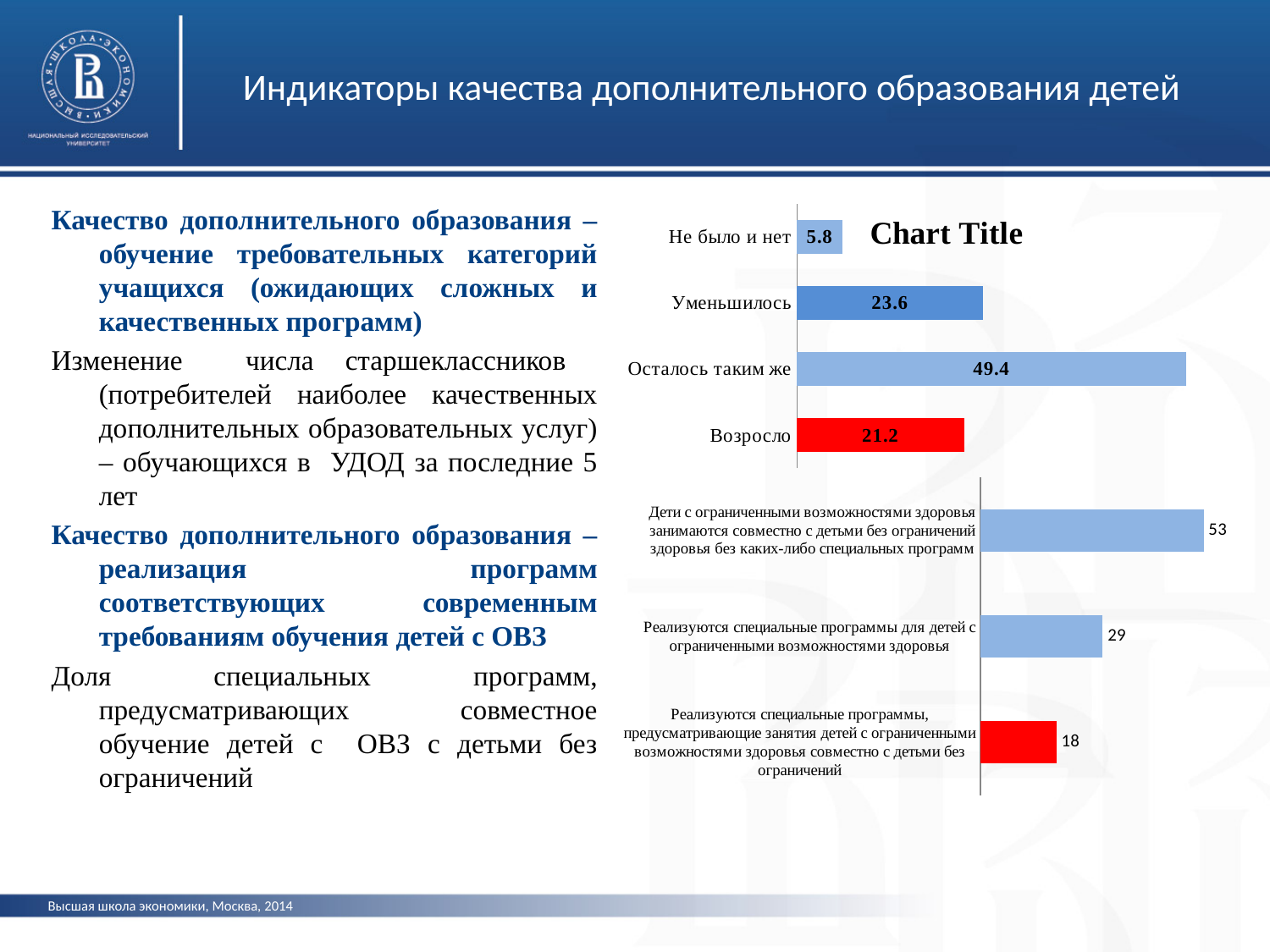
In the top chart, which category has the lowest value? Не было и нет In the bottom chart, what is the value for "Реализуются специальные программы для детей с ограниченными возможностями здоровья"? 29 In the top chart, how many categories are shown? 4 In the bottom chart, which category has the highest value? Дети с ограниченными возможностями здоровья занимаются совместно с детьми без ограничений здоровья без каких-либо специальных программ In the top chart, which category has the highest value? Осталось таким же What is the title shown on the top chart? Chart Title In the top chart, what is the value for "Возросло"? 21.2 In the top chart, what is the value for "Осталось таким же"? 49.4 In the top chart, what is the difference between "Уменьшилось" and "Возросло"? 2.4 In the bottom chart, what is the value for the category about special programmes providing joint classes for children with and without disabilities ("Реализуются специальные программы, предусматривающие занятия детей с ограниченными возможностями здоровья совместно с детьми без ограничений")? 18 What type of chart is the bottom chart? bar chart In the bottom chart, what is the difference between the highest value (53) and the lowest value (18)? 35